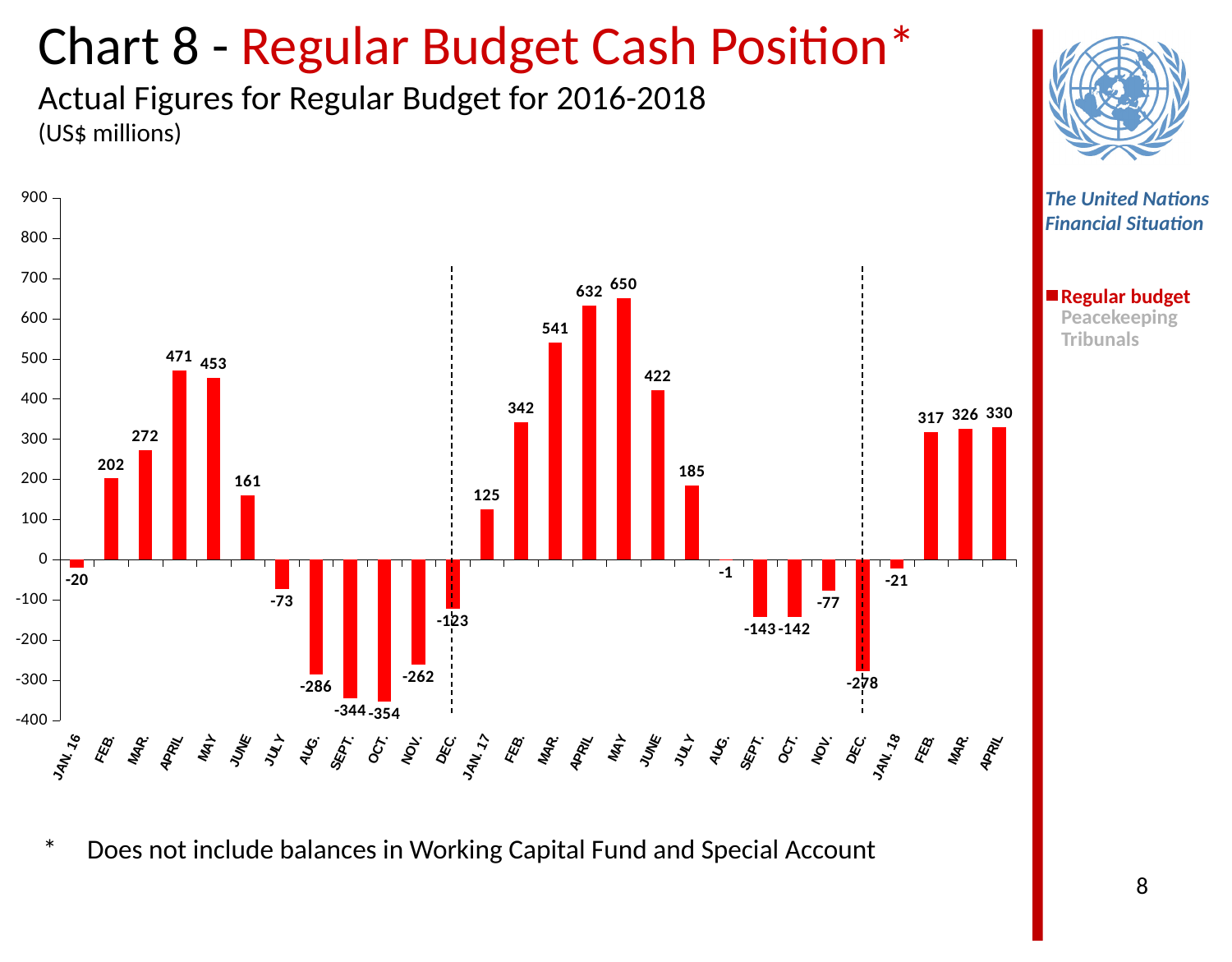
How many monthly bars are plotted in the chart? 28 Which month has the lowest regular budget cash position? October 2016 What is the difference between the values for April 2017 and March 2017? 91 How many entries does the legend list? 3 Which is larger, the value for February 2016 or the value for February 2017? February 2017 What is the regular budget cash position for May 2017? 650 What kind of chart is shown on the slide? bar chart Do the values rise or fall from January 2017 to May 2017? rise Is the value for September 2016 greater or less than -300? less Which month has the highest regular budget cash position? May 2017 What is the value shown for April 2018? 330 What is the value shown for October 2016? -354